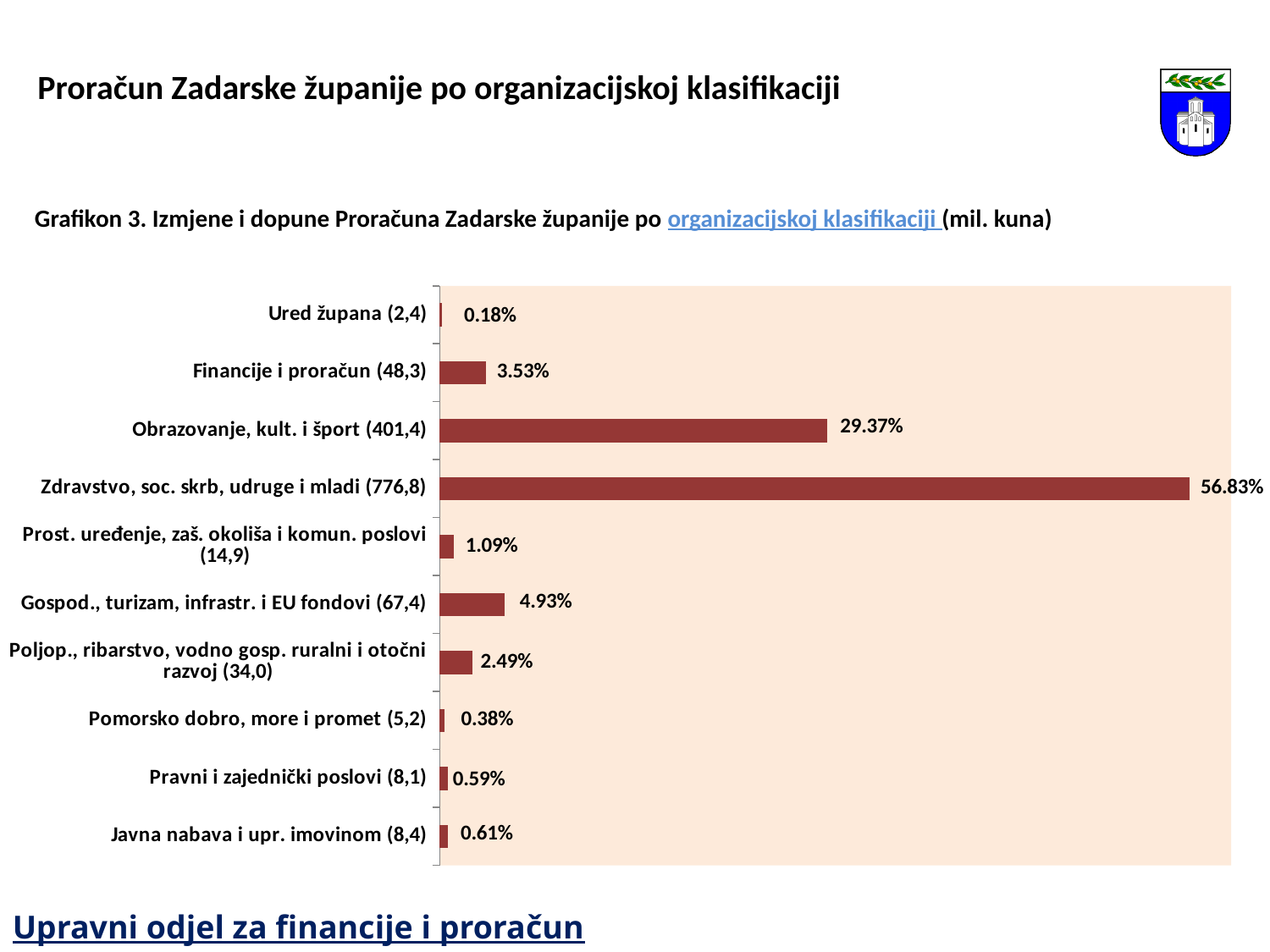
What is the difference in percentage points between Zdravstvo, soc. skrb, udruge i mladi and Obrazovanje, kult. i šport? 27.46 What unit is stated in the chart title for the values in parentheses? mil. kuna How many categories are shown in the chart? 10 Which category has the highest percentage? Zdravstvo, soc. skrb, udruge i mladi What percentage is shown for Gospod., turizam, infrastr. i EU fondovi? 4.93% What percentage is shown for Obrazovanje, kult. i šport? 29.37% What type of chart is shown on the slide? Bar chart What percentage is shown for Pomorsko dobro, more i promet? 0.38% Which has a larger percentage, Gospod., turizam, infrastr. i EU fondovi or Financije i proračun? Gospod., turizam, infrastr. i EU fondovi What percentage is shown for Financije i proračun? 3.53% What percentage is shown for Zdravstvo, soc. skrb, udruge i mladi? 56.83% Which category has the lowest percentage? Ured župana